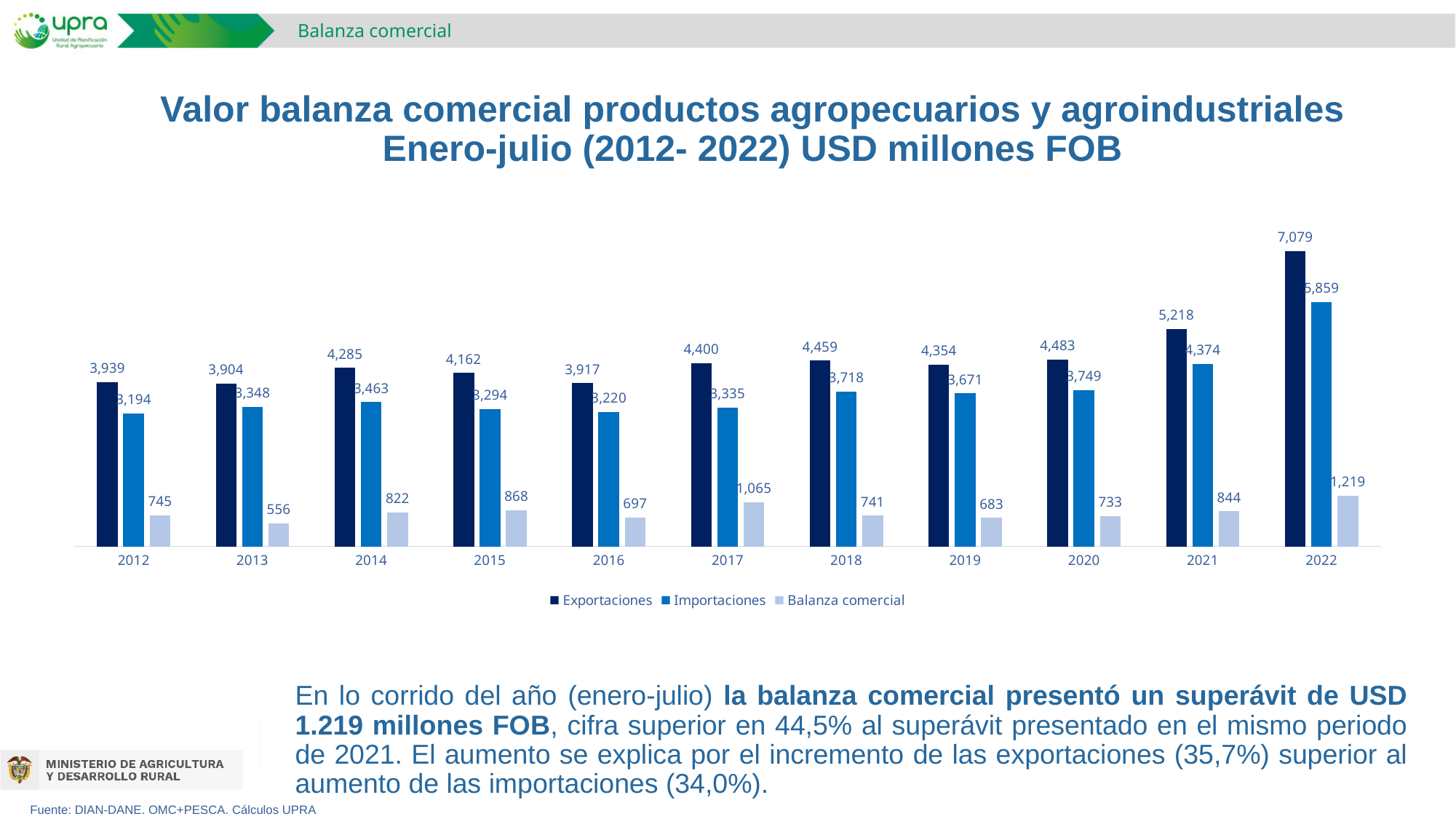
Do the Exportaciones values rise or fall from 2020 to 2022? rise How many series does the legend list? 3 What is the value of Exportaciones in 2022? 7,079 What is the value of Importaciones in 2021? 4,374 Which is larger, Balanza comercial in 2015 or in 2016? 2015 What is the difference between Exportaciones and Importaciones in 2022? 1,220 In which year is Exportaciones highest? 2022 What type of chart is shown on the slide? bar chart Which series is shown in the lightest colour in the legend? Balanza comercial What is the value of Balanza comercial in 2017? 1,065 In which year is Balanza comercial lowest? 2013 How many years are shown on the x axis? 11